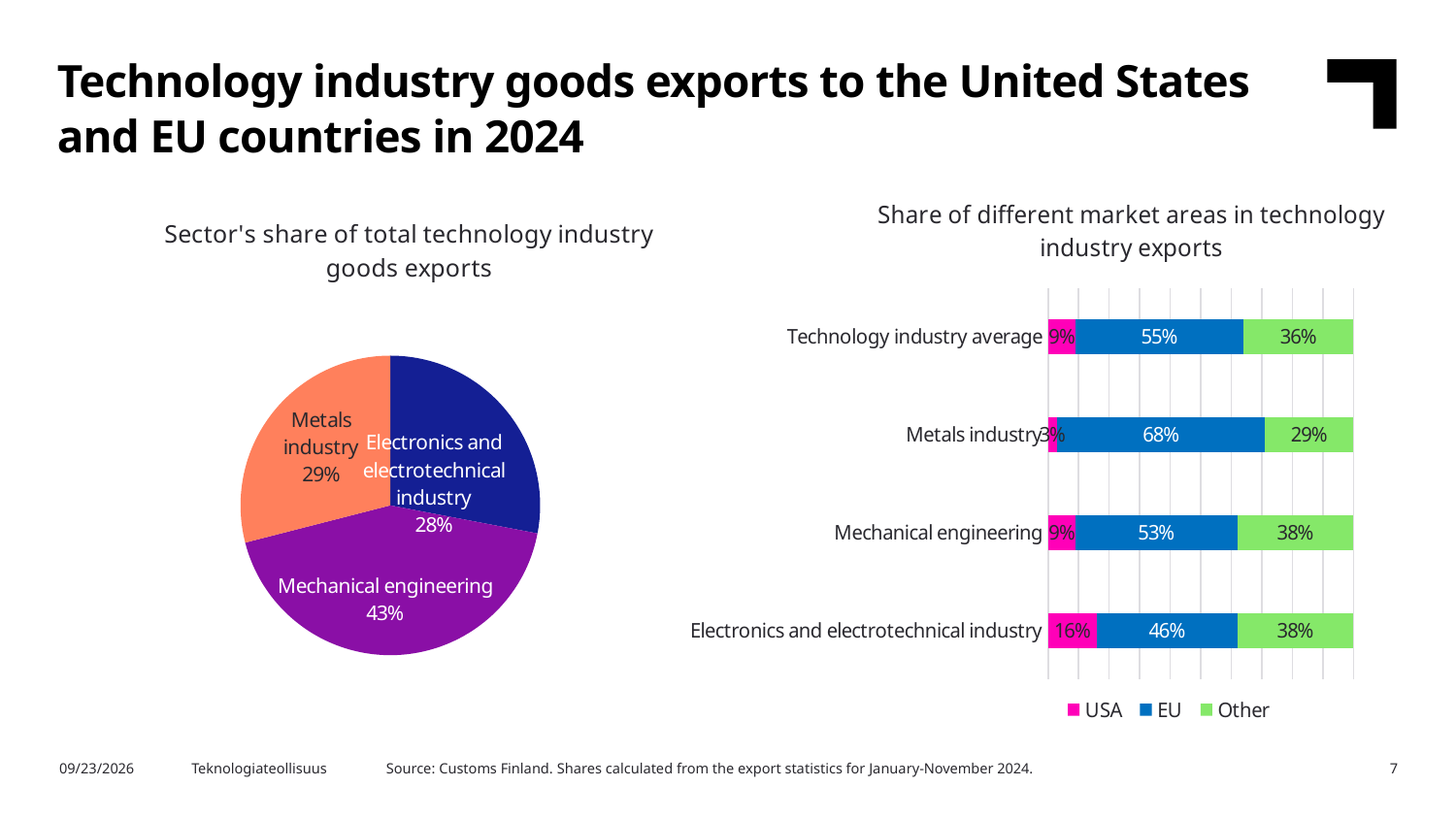
In the chart 'Share of different market areas in technology industry exports', what is the USA share for Electronics and electrotechnical industry? 16% In the chart 'Share of different market areas in technology industry exports', how many series does the legend list? 3 What type of chart is 'Share of different market areas in technology industry exports'? Stacked bar chart In the pie chart 'Sector's share of total technology industry goods exports', which sector has the largest share? Mechanical engineering In the chart 'Share of different market areas in technology industry exports', what is the difference between the EU share for Technology industry average and the EU share for Electronics and electrotechnical industry? 9% In the chart 'Share of different market areas in technology industry exports', what is the EU share for Metals industry? 68% In the chart 'Share of different market areas in technology industry exports', which category has the highest EU share? Metals industry In the pie chart 'Sector's share of total technology industry goods exports', which sector has the smallest share? Electronics and electrotechnical industry In the pie chart 'Sector's share of total technology industry goods exports', what share does Mechanical engineering have? 43% In the pie chart 'Sector's share of total technology industry goods exports', how many sectors are shown? 3 In the chart 'Share of different market areas in technology industry exports', which category has the lowest USA share? Metals industry In the chart 'Share of different market areas in technology industry exports', is the Other share larger for Mechanical engineering or for Metals industry? Mechanical engineering